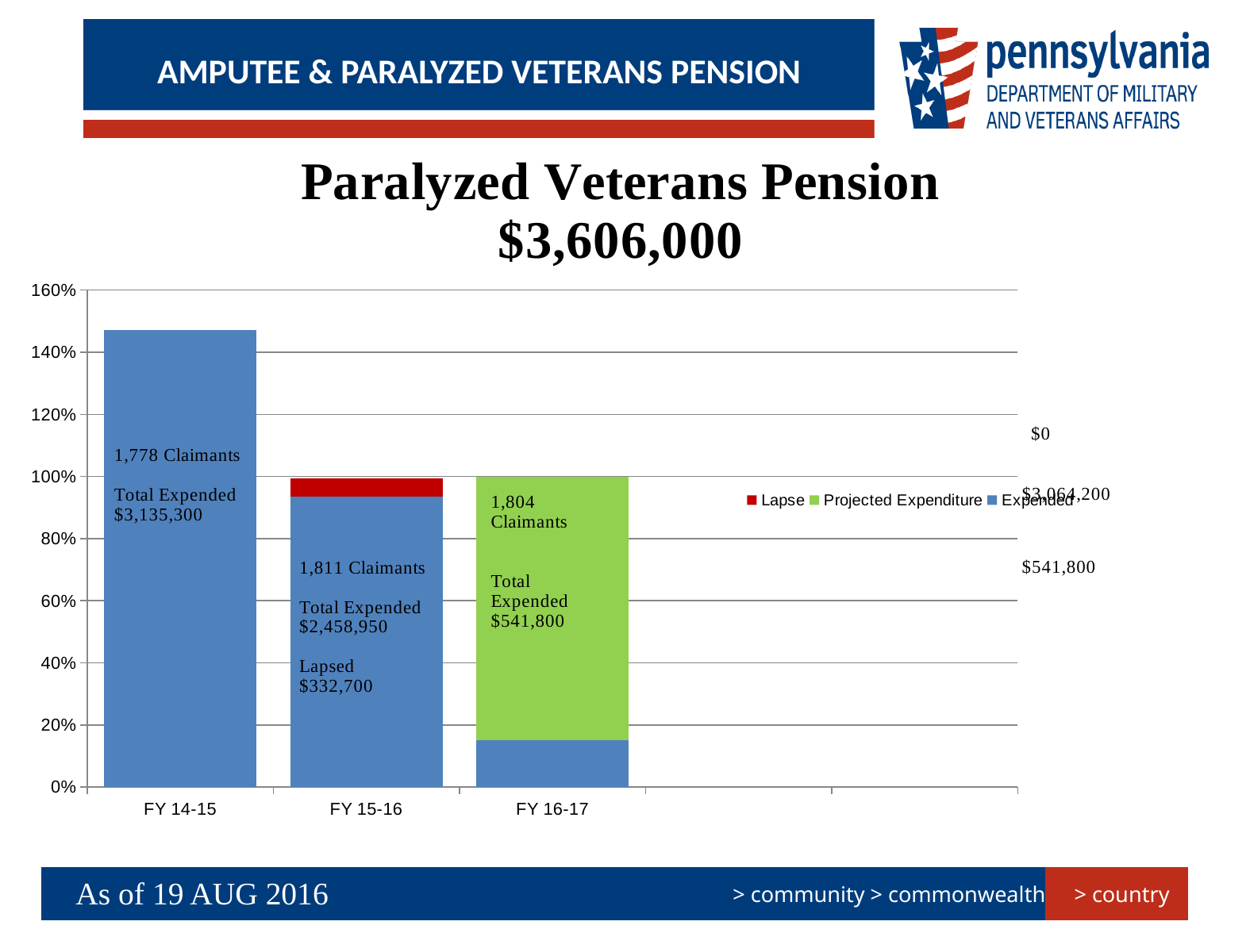
How many claimants are listed for FY 14-15? 1,778 Claimants How many fiscal year categories are shown on the x axis? 3 Which fiscal year has the tallest bar? FY 14-15 Is the total height of the FY 14-15 bar greater or less than 140%? greater What dollar amount appears in the chart title under "Paralyzed Veterans Pension"? $3,606,000 How many series does the legend list? 3 What is the Total Expended amount shown for FY 15-16? $2,458,950 What Lapsed amount is shown for FY 15-16? $332,700 How many claimants are listed for FY 16-17? 1,804 Claimants What are the three series named in the legend? Lapse, Projected Expenditure, Expended What kind of chart is shown on the slide? Stacked bar chart Is the Expended (blue) portion of the FY 16-17 bar greater or less than 20%? less